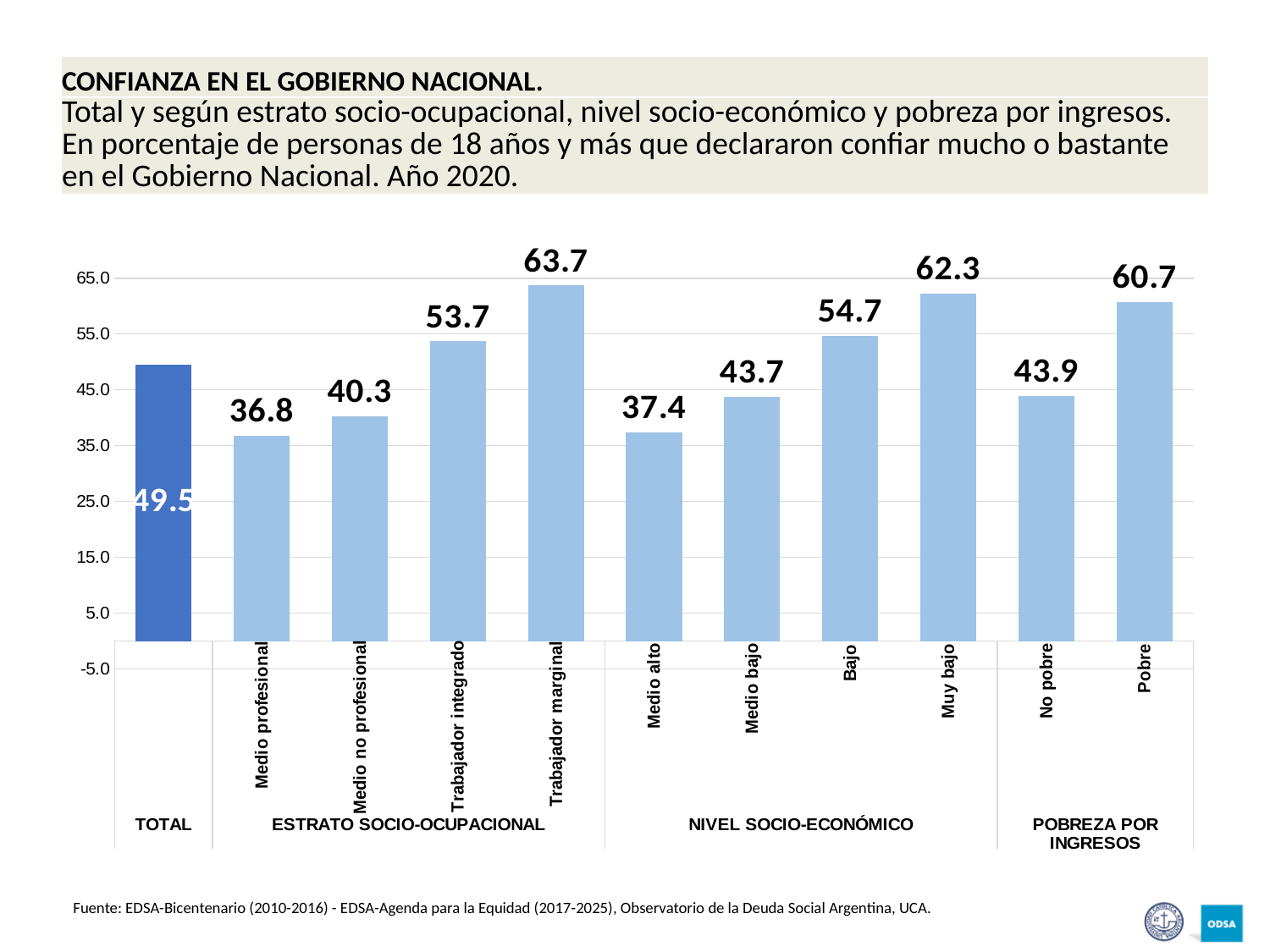
Is the value for Trabajador integrado greater or less than 45.0? greater What is the value for No pobre? 43.9 What is the value for the TOTAL bar? 49.5 What is the value for Muy bajo? 62.3 Which is larger, the value for Bajo or the value for Medio bajo? Bajo How many bars are plotted in the chart? 11 Which category has the lowest value? Medio profesional Which bar is shown in a darker blue than the others? TOTAL What is the value for Trabajador marginal? 63.7 What kind of chart is shown on the slide? bar chart What is the difference between the values for Pobre and No pobre? 16.8 Which category has the highest value? Trabajador marginal